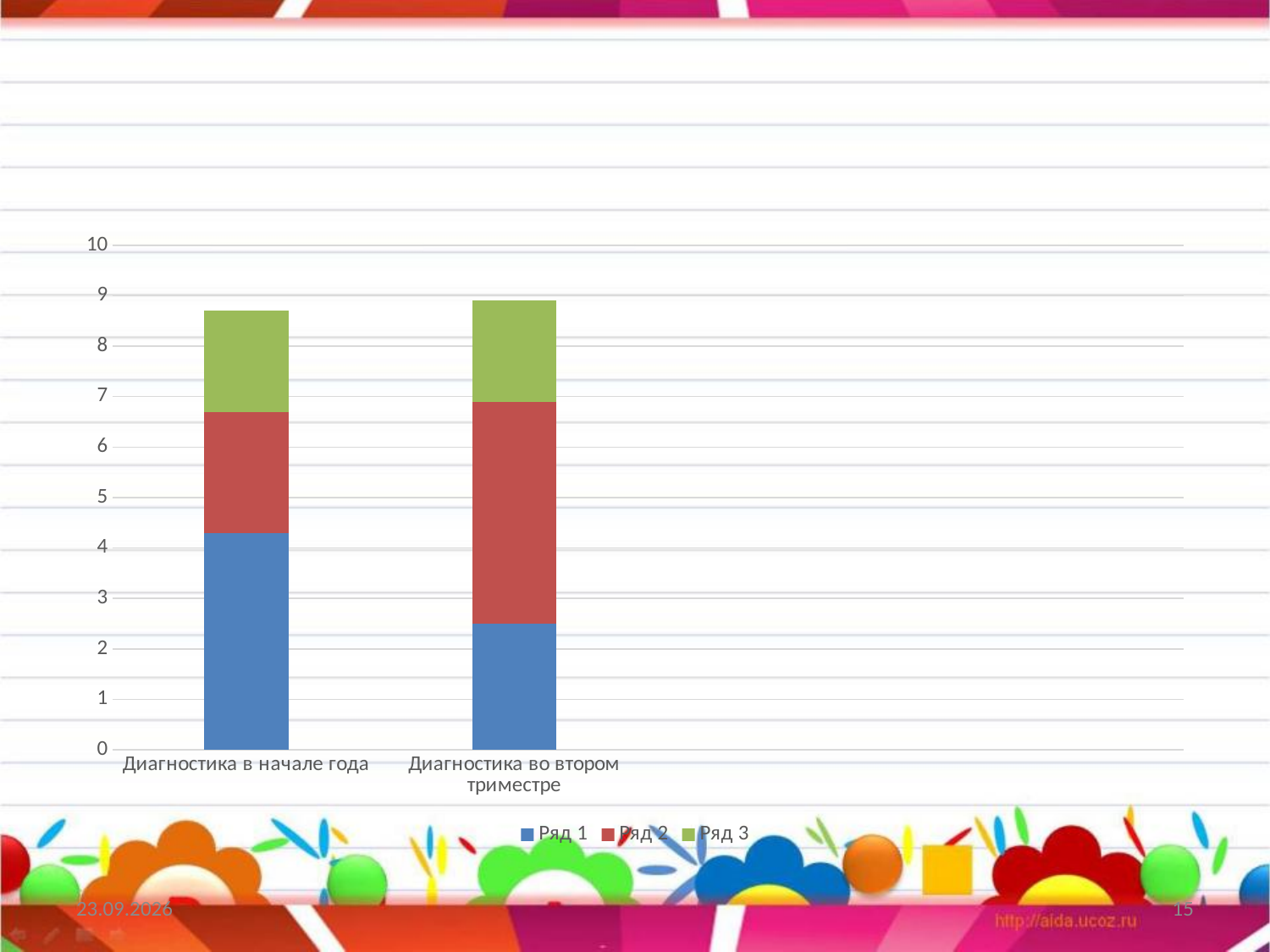
Which colour represents Ряд 1 in the chart? blue Is the total height of the stacked bar for "Диагностика во втором триместре" greater or less than 8? greater Is the total height of the stacked bar for "Диагностика в начале года" greater or less than 8? greater How many series does the chart legend list? 3 What kind of chart is shown on the slide? stacked bar chart Which category has the larger value for Ряд 2: "Диагностика в начале года" or "Диагностика во втором триместре"? Диагностика во втором триместре How many categories are shown on the x axis of the chart? 2 Which category has the larger value for Ряд 1: "Диагностика в начале года" or "Диагностика во втором триместре"? Диагностика в начале года What is the highest value shown on the vertical axis of the chart? 10 Is the value of Ряд 1 for "Диагностика во втором триместре" greater or less than 3? less What are the names of the series listed in the legend? Ряд 1, Ряд 2, Ряд 3